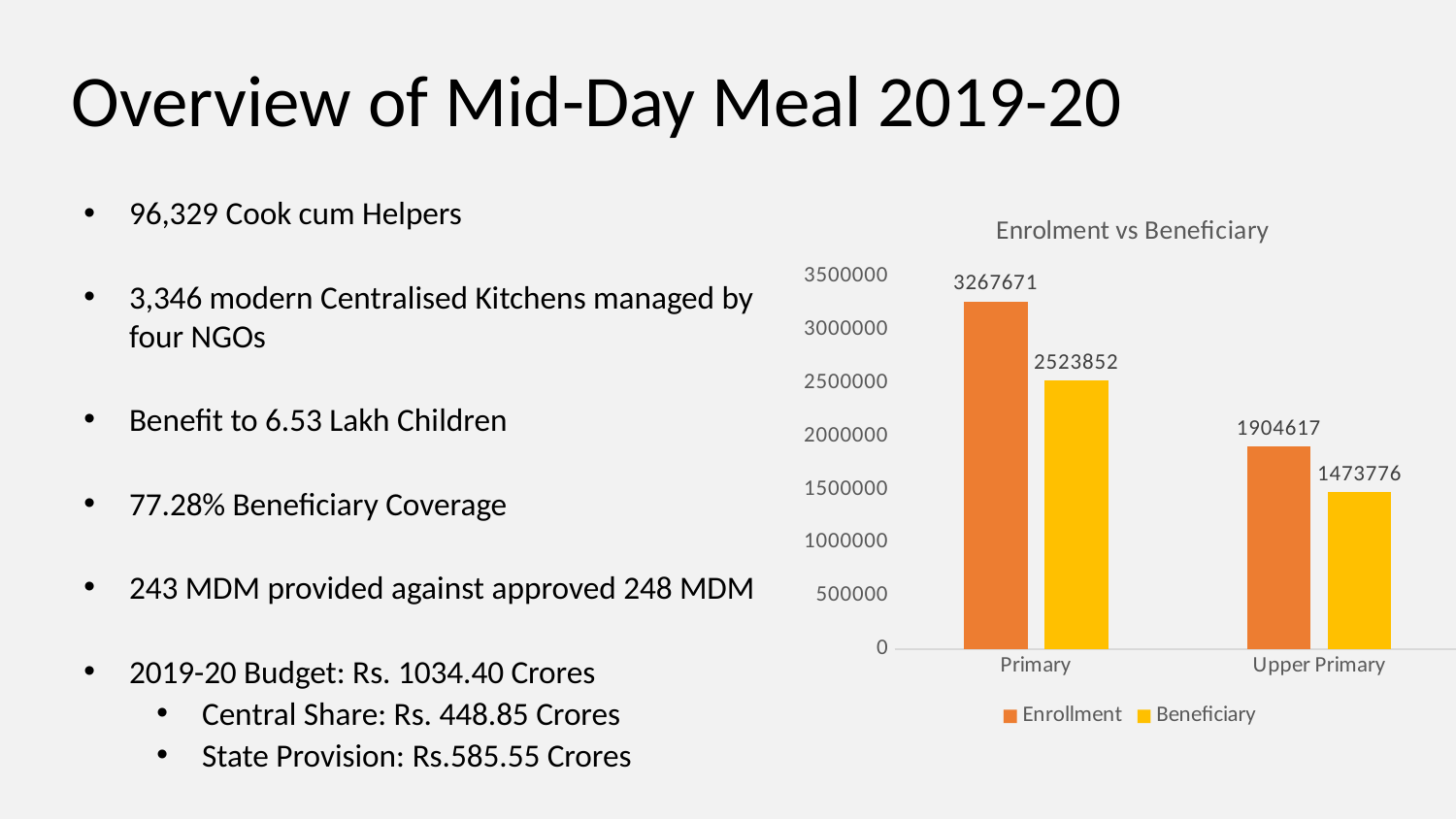
What is the Enrollment value for Primary? 3267671 What is the difference between Enrollment and Beneficiary for Primary? 743819 Which category has the lowest Beneficiary value? Upper Primary Which category has the highest Enrollment value? Primary How many series does the chart legend list? 2 What is the Beneficiary value for Primary? 2523852 Which is larger: the Beneficiary value for Primary or the Enrollment value for Upper Primary? Beneficiary value for Primary What is the difference between Enrollment and Beneficiary for Upper Primary? 430841 What is the Beneficiary value for Upper Primary? 1473776 What is the Enrollment value for Upper Primary? 1904617 What type of chart is shown on the slide? Bar chart How many categories are shown on the x axis of the chart? 2